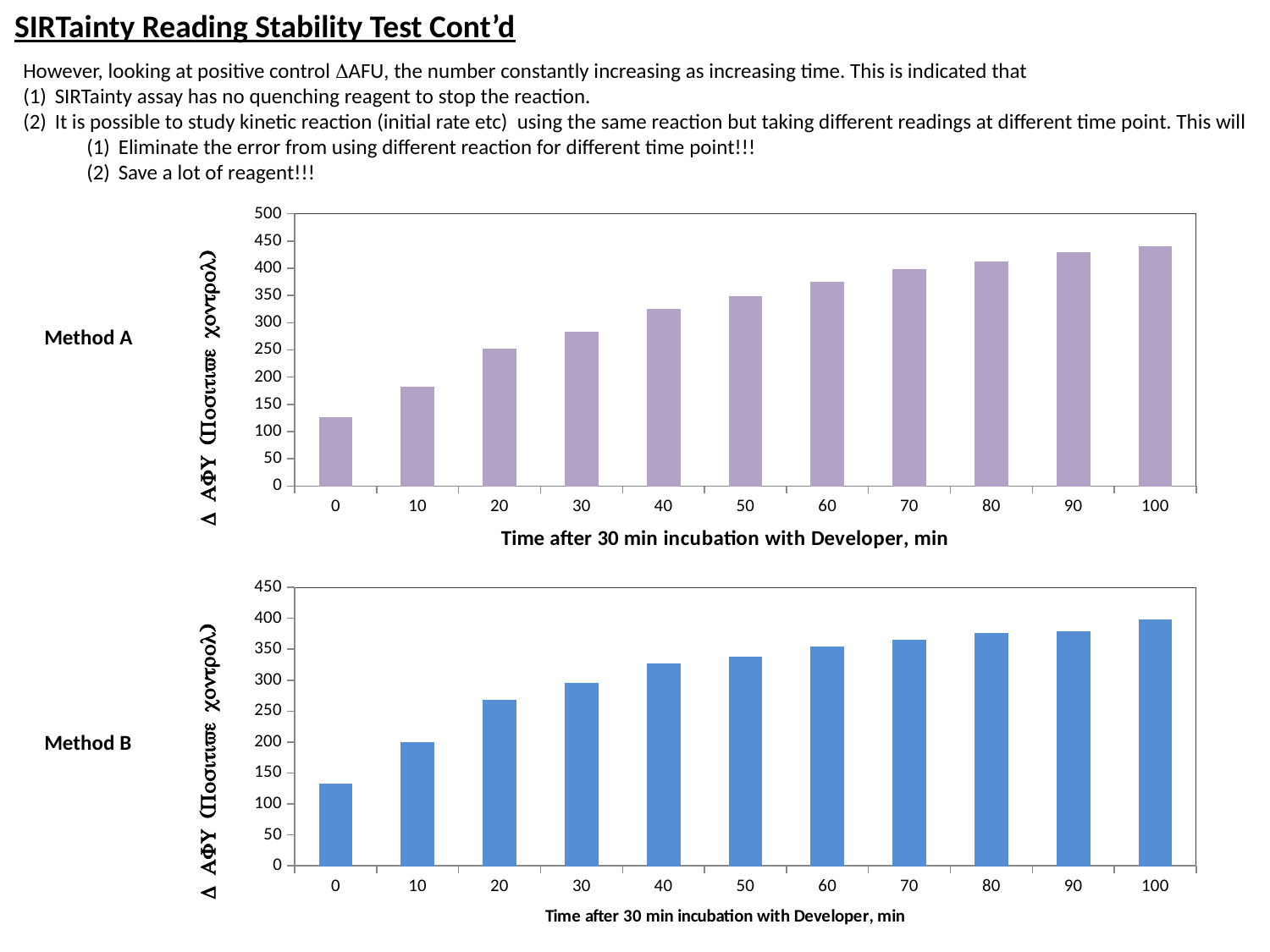
In the Method A chart, do the values rise or fall as time increases along the x axis? rise In the Method B chart, is the value at time 20 greater or less than 250? greater In the Method B chart, which time point has the highest value? 100 How many time points are plotted in the Method B chart? 11 In the Method B chart, is the value at time 40 greater or less than 300? greater In the Method A chart, which time point has the lowest value? 0 What is the x-axis title of the Method A chart? Time after 30 min incubation with Developer, min What is the highest value shown on the y axis of the Method B chart? 450 What kind of chart is the Method A chart? bar chart In the Method A chart, is the value at time 100 greater or less than 400? greater In the Method B chart, which is larger, the value at time 50 or the value at time 20? 50